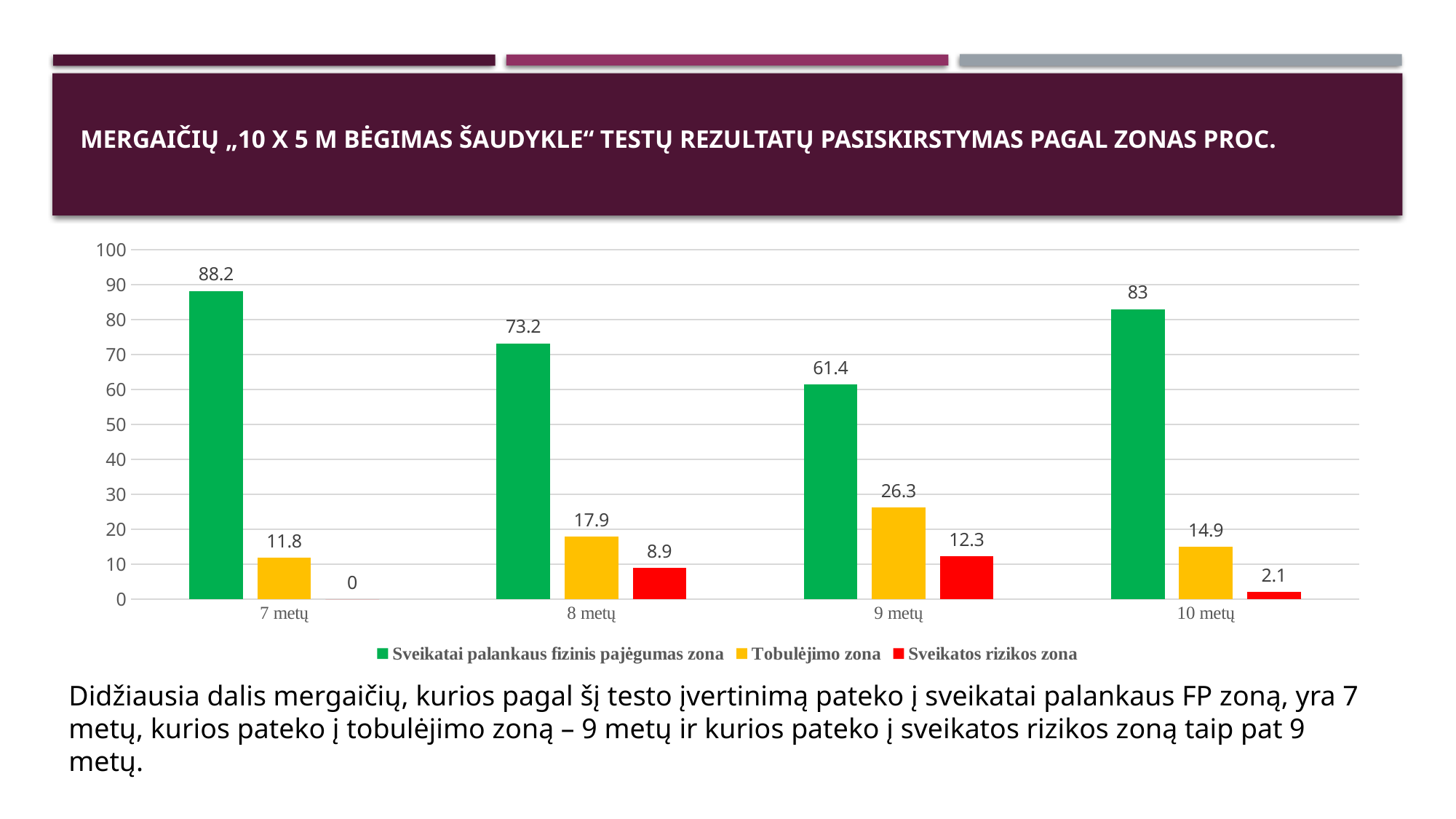
What kind of chart is shown on the slide? bar chart Is the value for "Sveikatai palankaus fizinis pajėgumas zona" for 10 metų greater or less than 80? greater What is the value for "Sveikatos rizikos zona" for 10 metų? 2.1 Which age group has the lowest value for "Sveikatai palankaus fizinis pajėgumas zona"? 9 metų How many series does the legend list? 3 What is the value for "Sveikatai palankaus fizinis pajėgumas zona" for 7 metų? 88.2 What is the difference between the "Sveikatai palankaus fizinis pajėgumas zona" values for 7 metų and 8 metų? 15 Which age group has the highest value for "Sveikatos rizikos zona"? 9 metų What is the value for "Tobulėjimo zona" for 9 metų? 26.3 What colour are the bars for "Sveikatos rizikos zona"? red How many age groups are shown on the x axis? 4 Which is larger: the "Tobulėjimo zona" value for 8 metų or for 10 metų? 8 metų